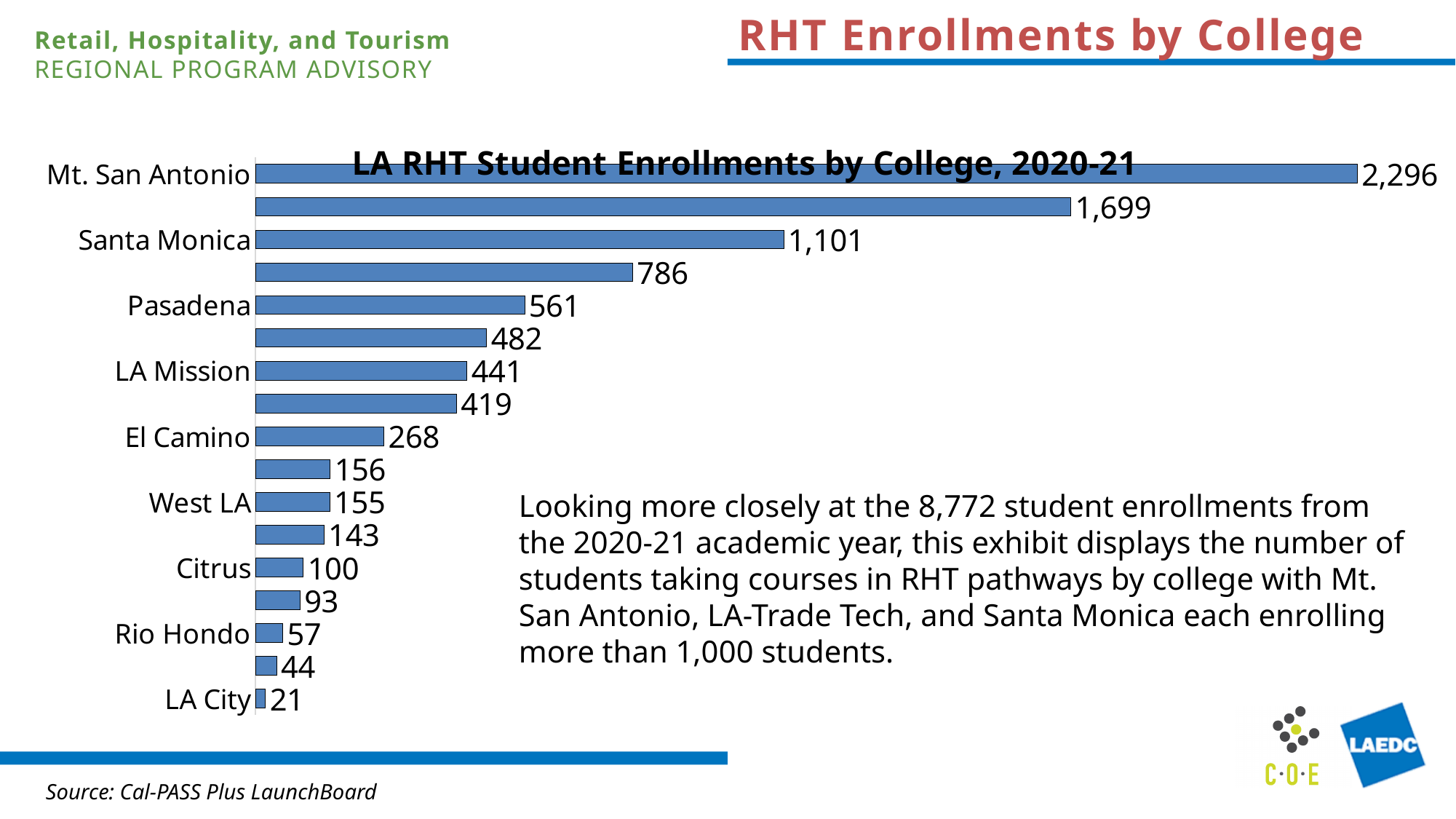
Which college has the lowest number of RHT student enrollments? LA City What is the number of RHT student enrollments for El Camino? 268 What is the title of the chart? LA RHT Student Enrollments by College, 2020-21 Which college has more RHT enrollments, LA Mission or West LA? LA Mission What is the number of RHT student enrollments for Pasadena? 561 Which college has the highest number of RHT student enrollments? Mt. San Antonio How many bars are plotted in the chart? 17 What is the number of RHT student enrollments for Mt. San Antonio? 2,296 What is the number of RHT student enrollments for Santa Monica? 1,101 What type of chart is shown on the slide? Bar chart What is the number of RHT student enrollments for Rio Hondo? 57 What is the difference in enrollments between Mt. San Antonio and Santa Monica? 1,195